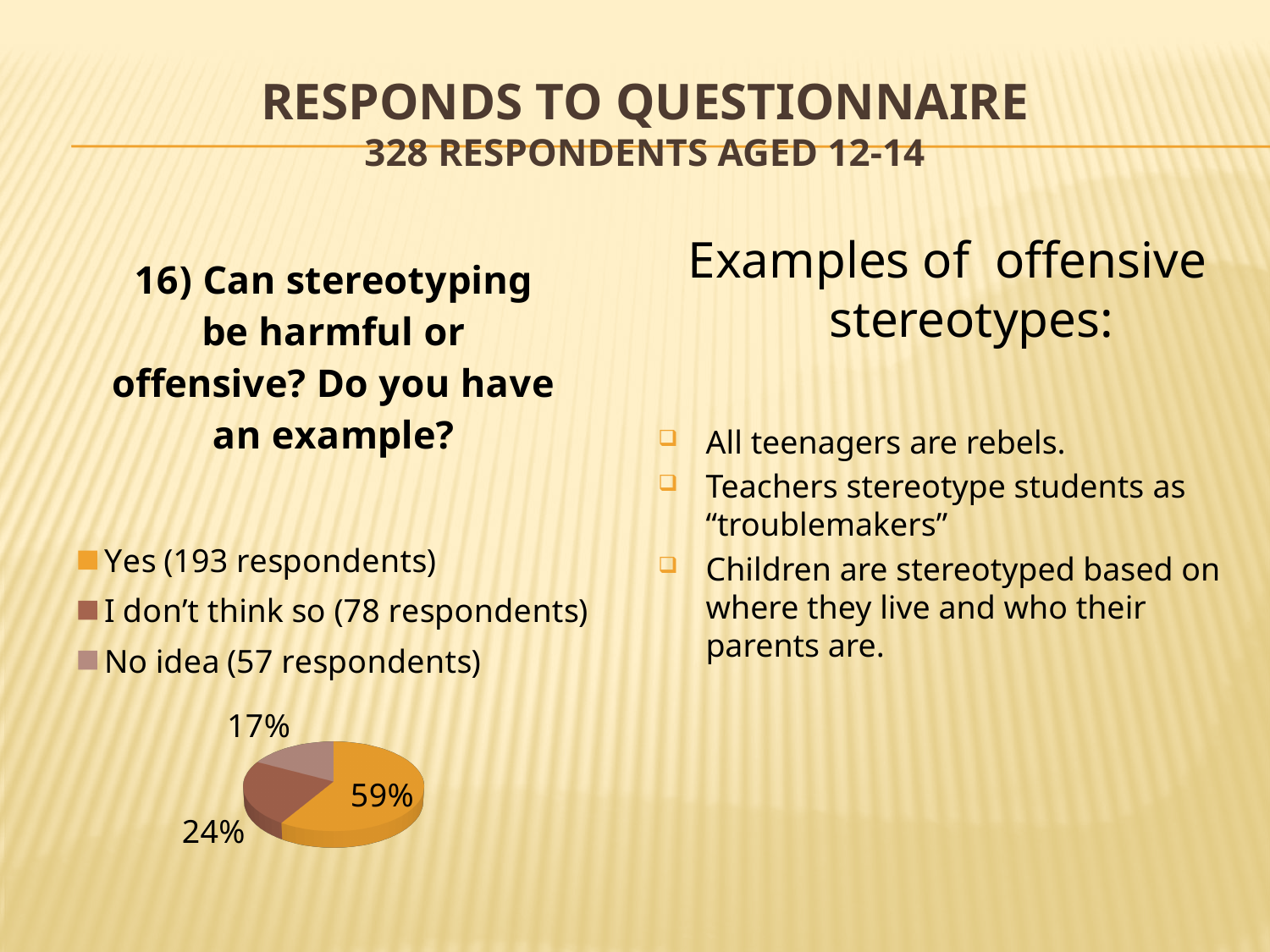
What kind of chart is shown on the slide? pie chart How many slices does the pie chart have? 3 Which slice is larger: "I don't think so" or "No idea"? I don't think so Which response has the largest slice of the pie? Yes What percentage of the pie does the "I don't think so" slice represent? 24% How many respondents answered "Yes" according to the legend? 193 respondents What colour is the "Yes" slice of the pie chart? orange Which response has the smallest slice of the pie? No idea How many respondents answered "No idea" according to the legend? 57 respondents What is the difference in percentage points between the "Yes" slice and the "I don't think so" slice? 35 percentage points What percentage of the pie does the "Yes" slice represent? 59% What percentage of the pie does the "No idea" slice represent? 17%